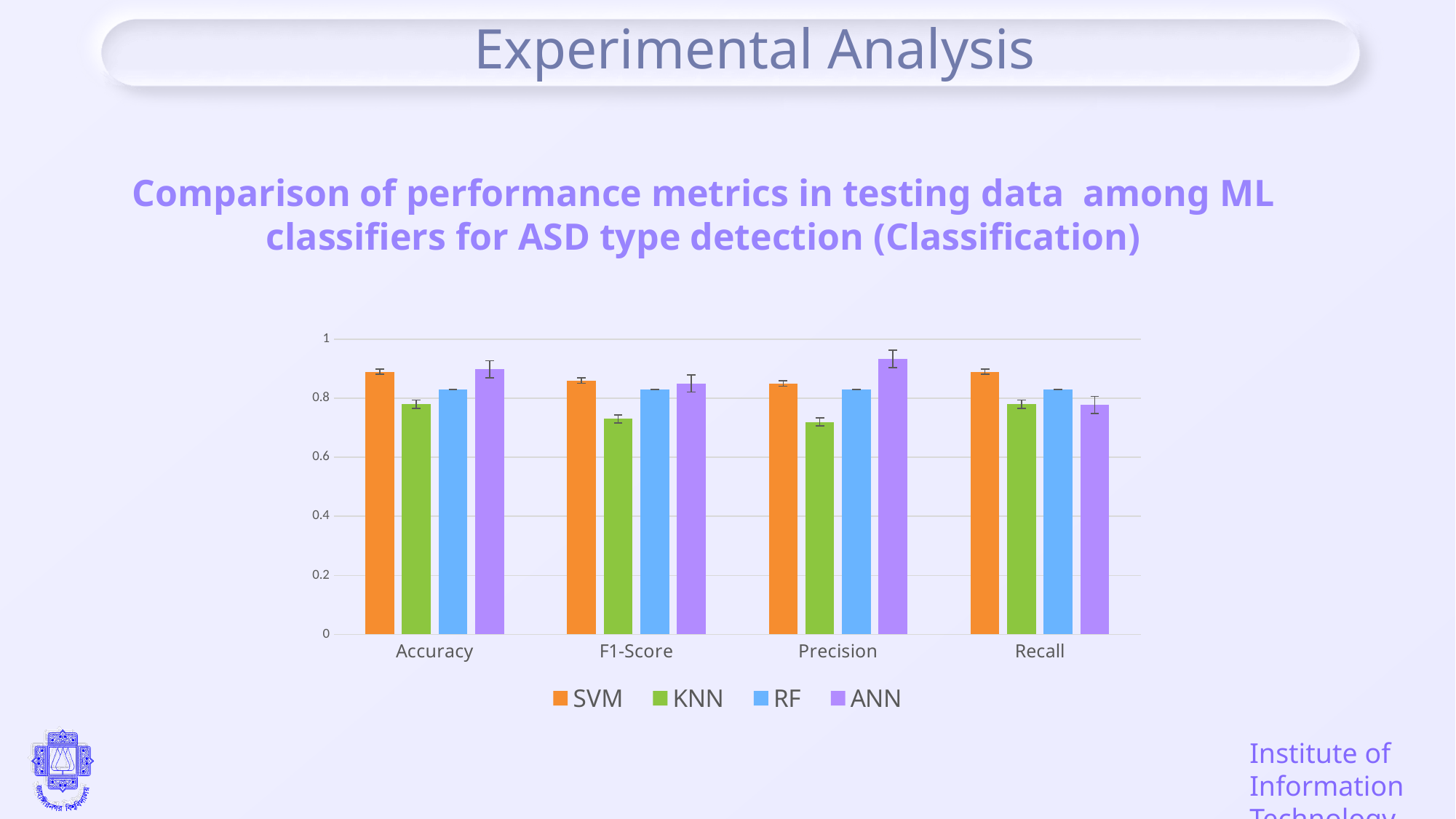
What kind of chart is shown on the slide? bar chart Which classifier has the highest Precision? ANN Is the Precision value for ANN greater or less than 0.8? greater How many performance metric categories are shown on the x axis? 4 Is the Recall value for SVM greater or less than 0.8? greater Which classifier has the lowest F1-Score? KNN Which series is shown in orange in the legend? SVM For Accuracy, which is larger: the value for SVM or the value for KNN? SVM Which classifier has the highest Recall? SVM How many series does the legend list? 4 Is the F1-Score value for KNN greater or less than 0.8? less Which classifier has the lowest Precision? KNN